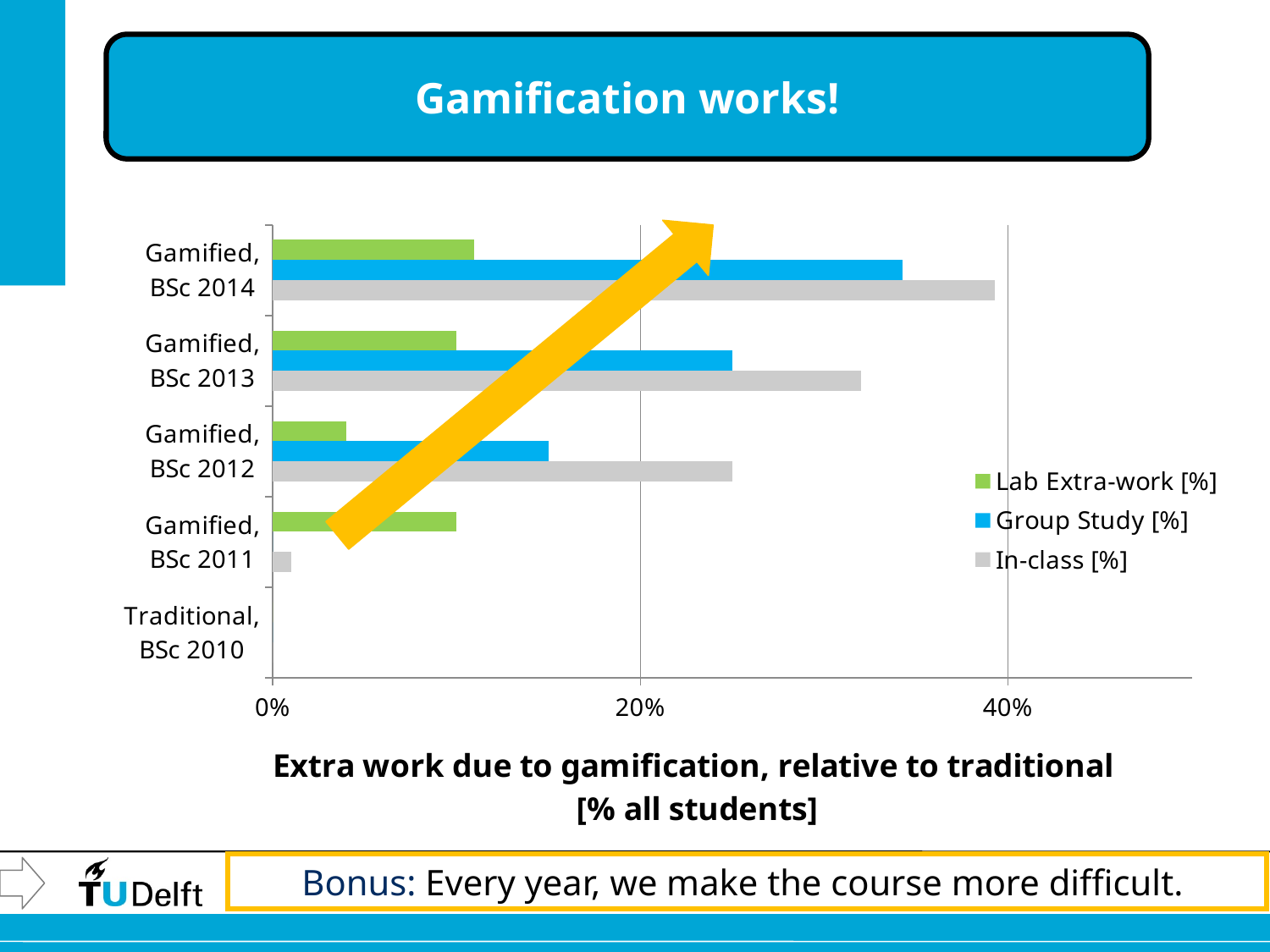
Which is larger for Gamified, BSc 2012: the Group Study [%] value or the Lab Extra-work [%] value? Group Study [%] Which category has the highest Group Study [%] value? Gamified, BSc 2014 Is the In-class [%] value for Gamified, BSc 2013 greater or less than 20%? greater What kind of chart is shown on the slide? bar chart How many series does the legend list? 3 Which category has the highest In-class [%] value? Gamified, BSc 2014 Does the In-class [%] value rise or fall from Gamified, BSc 2011 to Gamified, BSc 2014? rise Which series is shown in green? Lab Extra-work [%] Is the Group Study [%] value for Gamified, BSc 2014 greater or less than 40%? less Is the Lab Extra-work [%] value for Gamified, BSc 2012 greater or less than 20%? less What is the title of the chart? Extra work due to gamification, relative to traditional [% all students] How many categories are shown on the vertical axis? 5